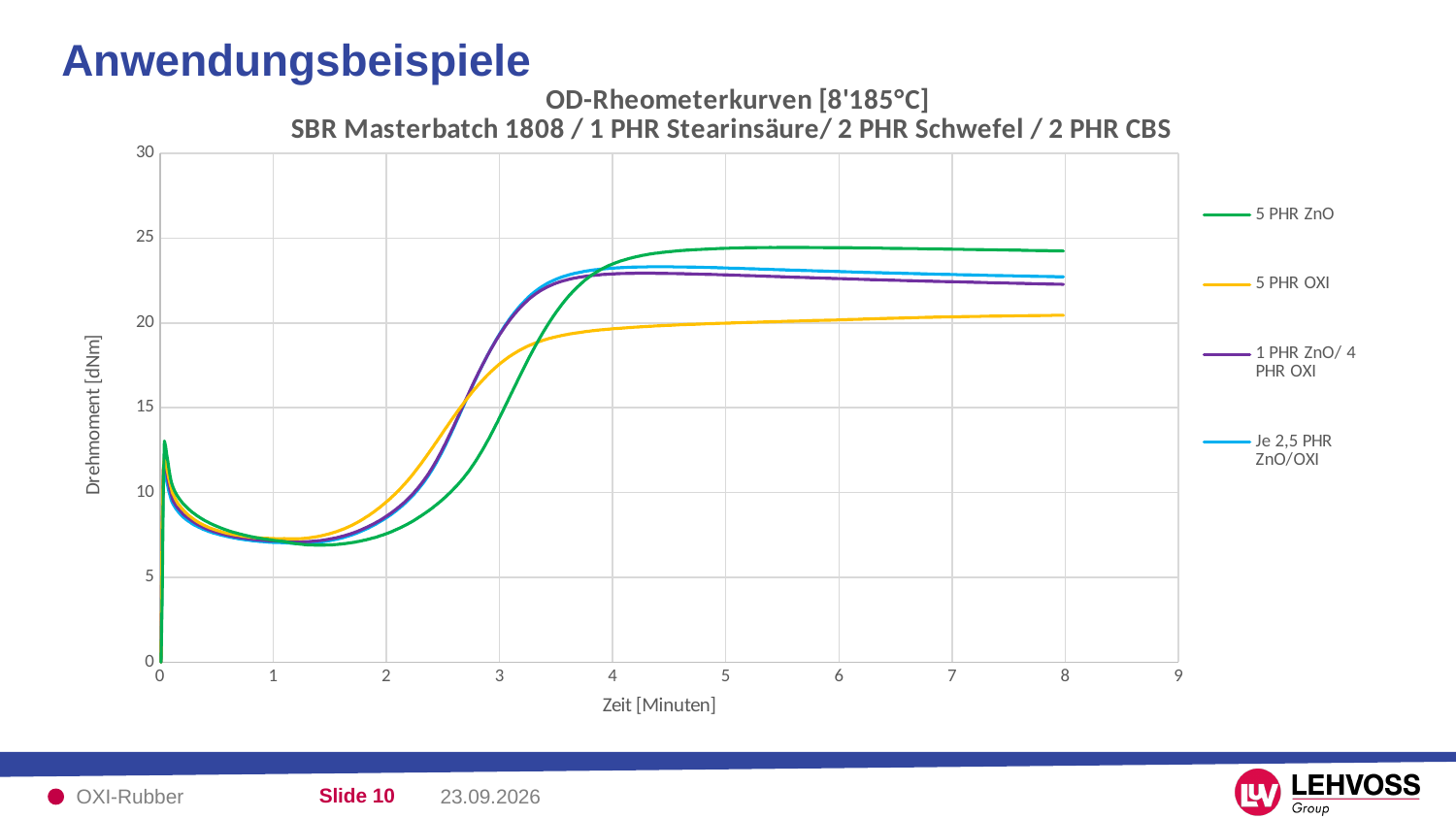
What is the label of the y axis? Drehmoment [dNm] At 8 minutes, which is larger: the value for 5 PHR ZnO or for 5 PHR OXI? 5 PHR ZnO Is the value for 5 PHR ZnO at 2 minutes greater or less than 10? less Which series has the highest torque at 8 minutes? 5 PHR ZnO Between 2 and 4 minutes, does the 5 PHR ZnO curve rise or fall? rise How many series does the legend list? 4 Is the value for 5 PHR OXI at 6 minutes greater or less than 25? less Which series has the lowest torque at 8 minutes? 5 PHR OXI Is the value for 5 PHR ZnO at 8 minutes greater or less than 20? greater What are the four series listed in the legend? 5 PHR ZnO, 5 PHR OXI, 1 PHR ZnO/ 4 PHR OXI, Je 2,5 PHR ZnO/OXI What kind of chart is shown on the slide? line chart At 3 minutes, which is larger: the value for 5 PHR OXI or for 5 PHR ZnO? 5 PHR OXI